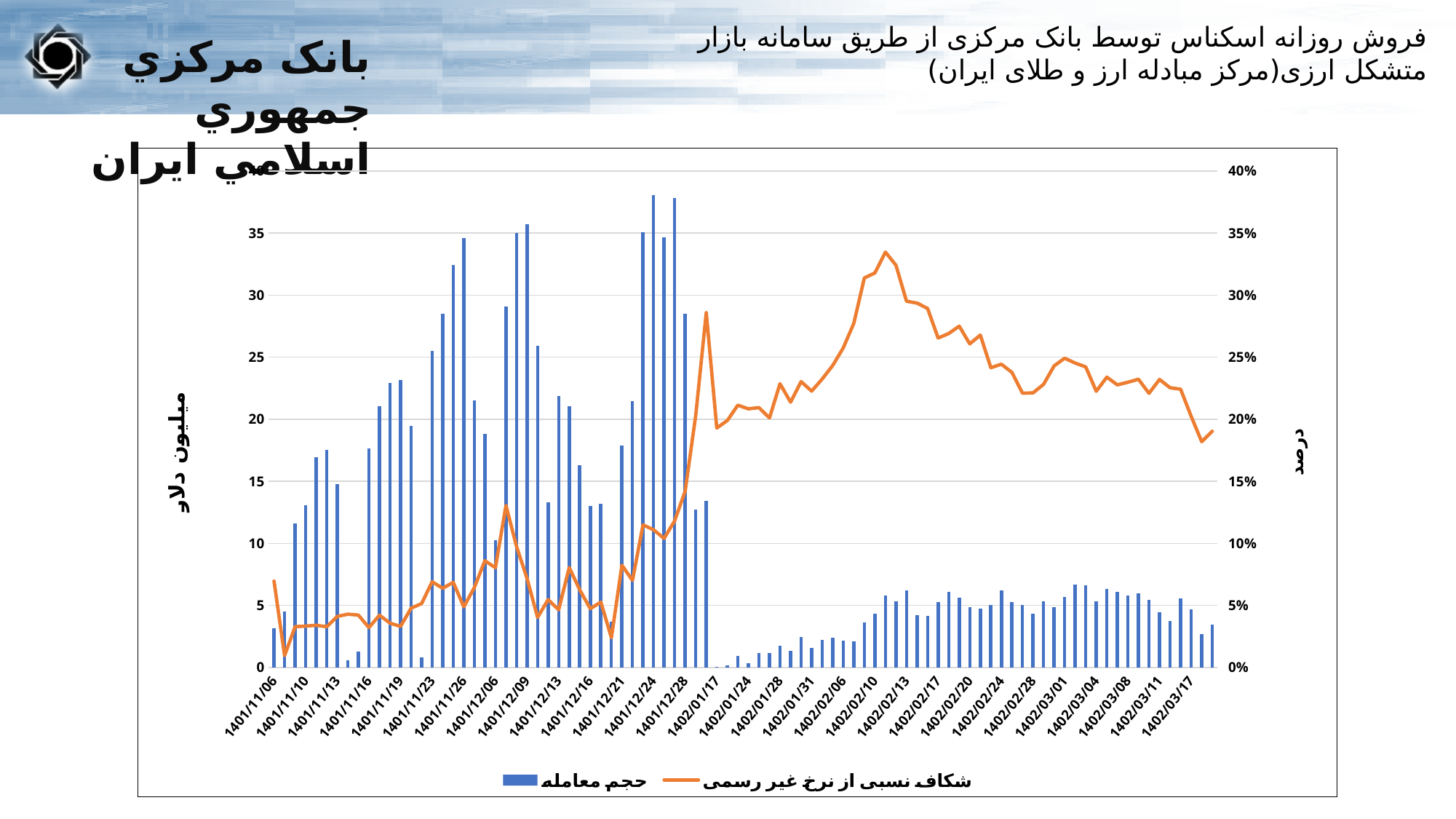
Is the value of the حجم معامله bar for 1401/11/26 greater or less than 30? greater Is the value of the شکاف نسبی از نرخ غیر رسمی line at 1401/11/10 greater or less than 5%? less Is the value of the حجم معامله bar for 1401/11/06 greater or less than 5? less How many series does the legend list? 2 Which series is drawn as bars according to the legend? حجم معامله Which is larger: the حجم معامله bar for 1401/11/26 or the bar for 1402/02/13? 1401/11/26 Does the شکاف نسبی از نرخ غیر رسمی line rise or fall between 1402/02/10 and 1402/03/17? fall What is the unit shown on the left vertical axis title? میلیون دلار What kind of chart is shown on the slide? A combined bar and line chart